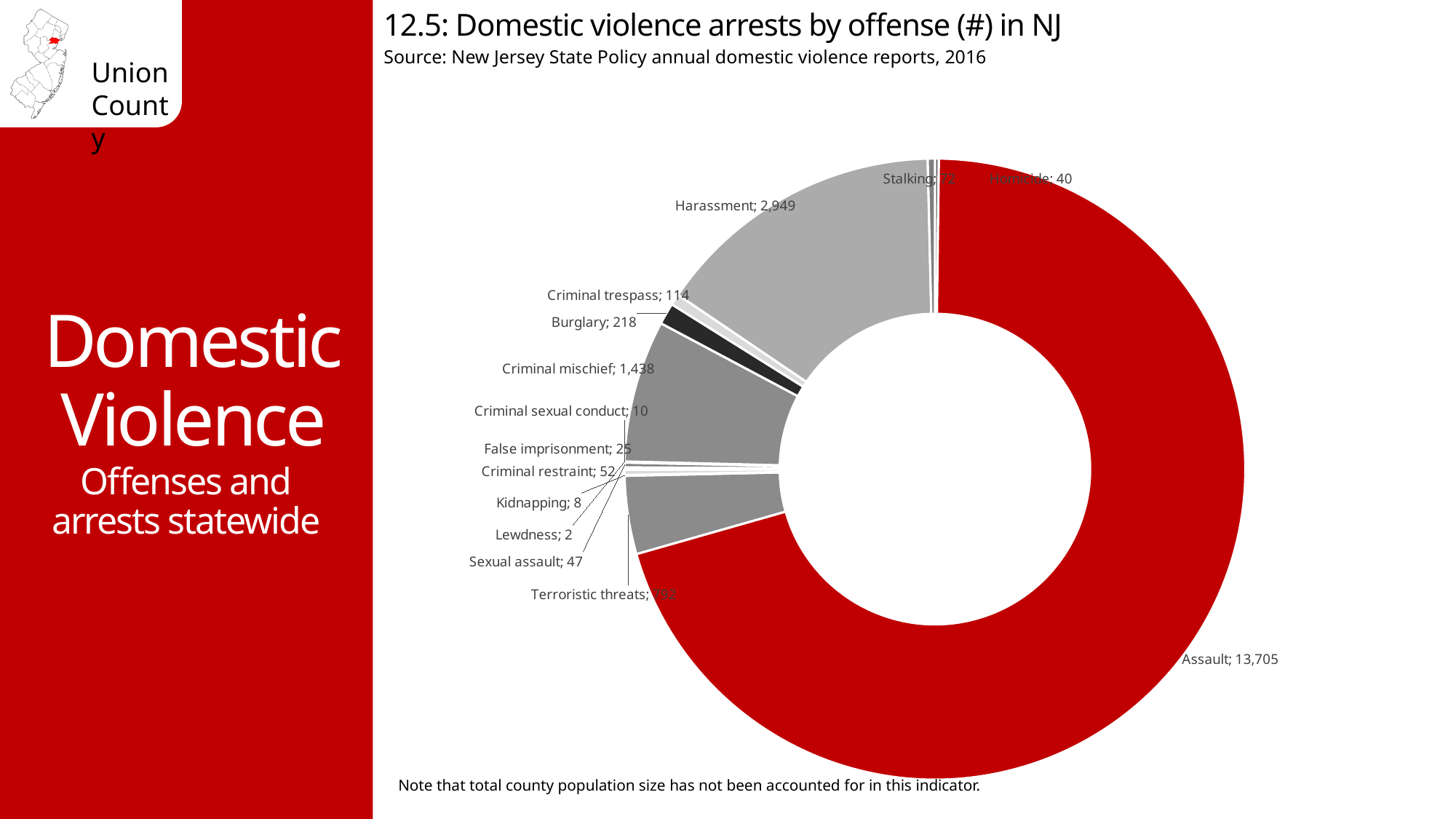
What is the value for Criminal mischief? 1,438 What is the value for Homicide? 40 Which offense has the largest number of arrests? Assault Which is larger, the value for Burglary or the value for Criminal trespass? Burglary What is the difference between the Harassment and Criminal mischief values? 1,511 Which offense has the smallest number of arrests? Lewdness What is the title of the chart? 12.5: Domestic violence arrests by offense (#) in NJ How many arrests for Harassment are shown in the chart? 2,949 What is the value for Burglary? 218 How many arrests for Assault are shown in the chart? 13,705 What kind of chart is shown on the slide? Pie chart (doughnut) How many offense categories are shown in the chart? 14